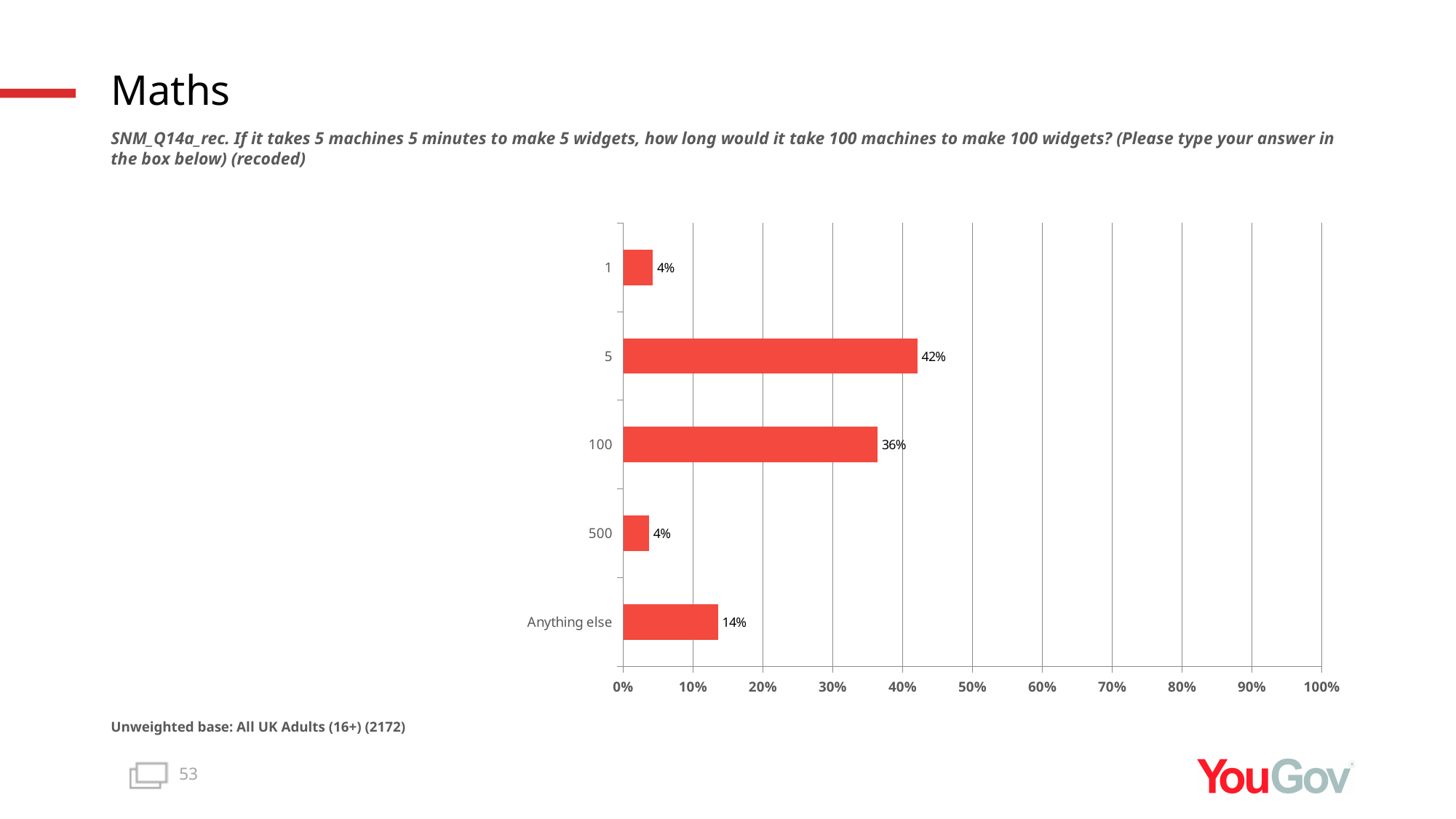
What percentage of respondents answered "500"? 4% What kind of chart is shown on the slide? Bar chart What percentage of respondents answered "Anything else"? 14% What percentage of respondents answered "5"? 42% What is the difference in percentage points between the "5" and "100" categories? 6 What percentage of respondents answered "100"? 36% Which is larger, the value for "100" or the value for "Anything else"? 100 How many answer categories are shown on the chart? 5 Which answer category has the highest percentage? 5 Is the value for "5" greater or less than 40%? greater What is the unweighted base size stated on the slide? 2172 What is the difference in percentage points between "Anything else" and "1"? 10